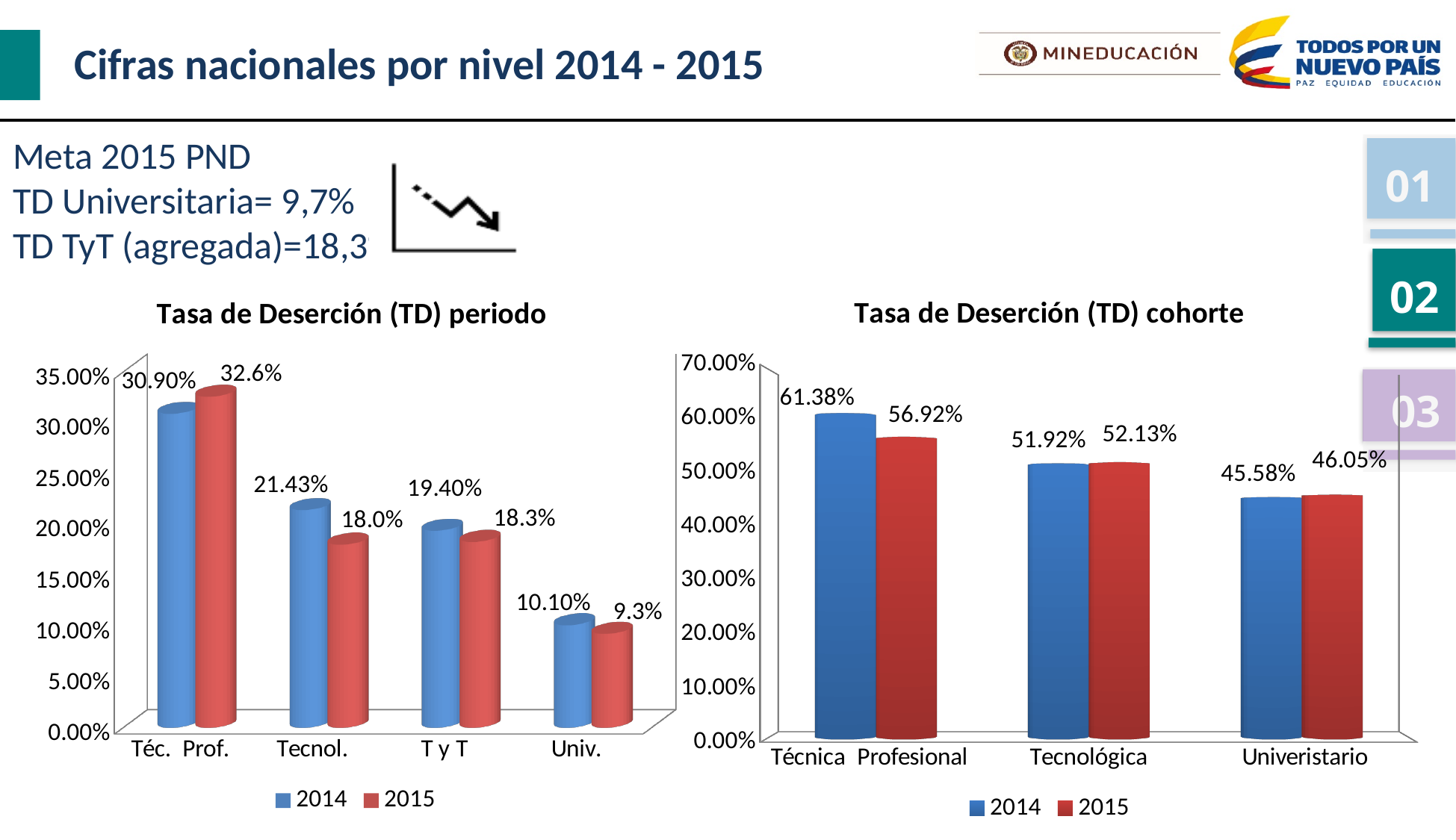
How many series does the legend of the 'Tasa de Deserción (TD) cohorte' chart list? 2 In the 'Tasa de Deserción (TD) cohorte' chart, what is the difference between the 2014 and 2015 values for Técnica Profesional? 4.46 percentage points What kind of chart is the 'Tasa de Deserción (TD) cohorte' chart? Bar chart In the 'Tasa de Deserción (TD) cohorte' chart, what is the 2014 value for Univeristario? 45.58% In the 'Tasa de Deserción (TD) periodo' chart, which category has the lowest 2015 value? Univ. How many categories are shown on the x axis of the 'Tasa de Deserción (TD) periodo' chart? 4 In the 'Tasa de Deserción (TD) cohorte' chart, do the 2014 values rise or fall from left to right across the categories? Fall In the 'Tasa de Deserción (TD) cohorte' chart, which category has the highest 2014 value? Técnica Profesional In the 'Tasa de Deserción (TD) periodo' chart, what is the 2014 value for Téc. Prof.? 30.90% In the 'Tasa de Deserción (TD) cohorte' chart, what is the 2015 value for Técnica Profesional? 56.92% In the 'Tasa de Deserción (TD) periodo' chart, which is larger for Tecnol.: the 2014 value or the 2015 value? 2014 In the 'Tasa de Deserción (TD) periodo' chart, what is the 2015 value for Tecnol.? 18.0%